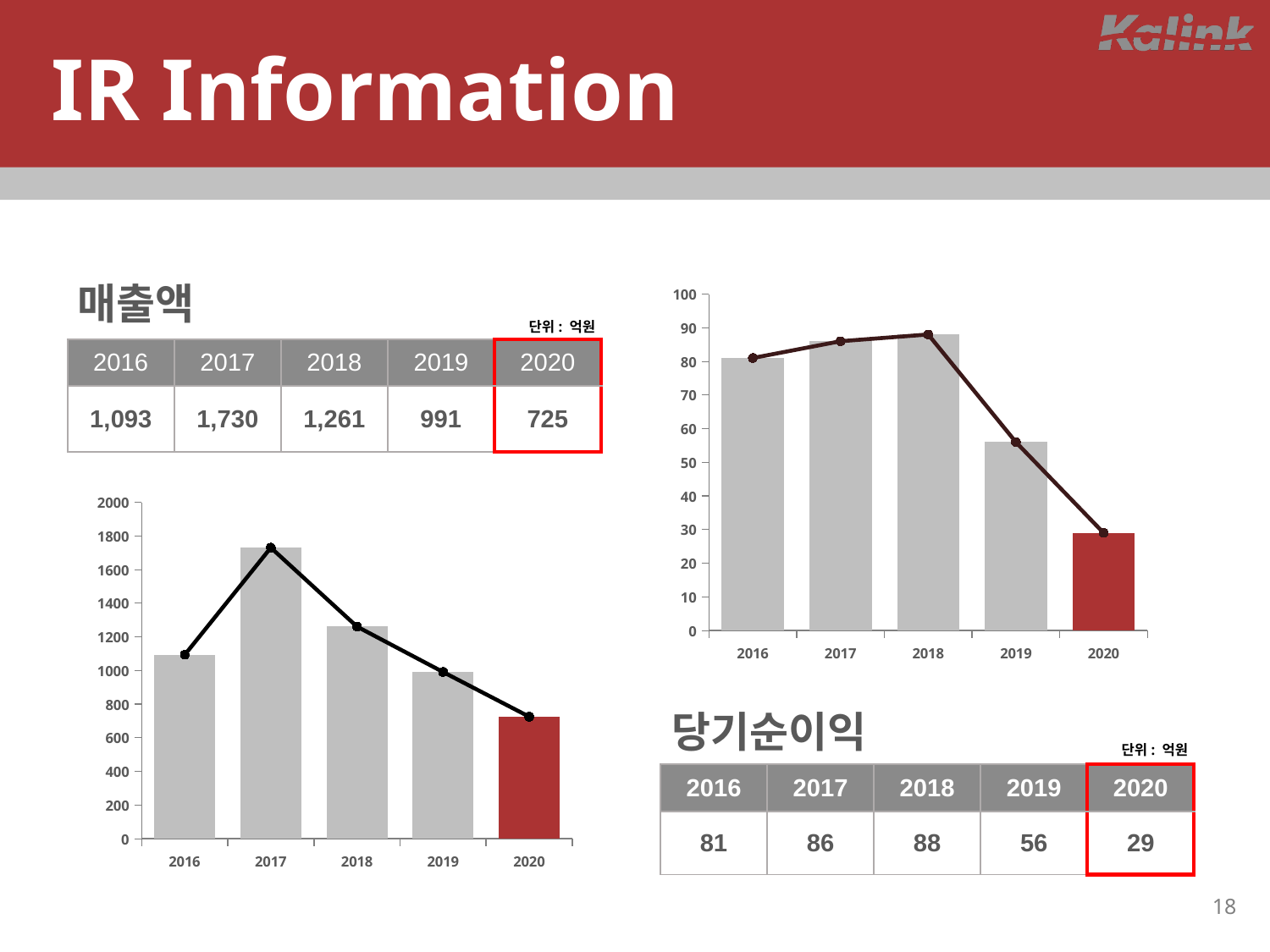
In the 매출액 chart on the left, which year has the lowest value? 2020 In the 매출액 chart on the left, is the value for 2019 greater or less than 1000? less In the 매출액 chart on the left, do the values rise or fall from 2017 to 2020? fall In the 당기순이익 chart on the right, which is larger, the value for 2016 or the value for 2019? 2016 In the 당기순이익 chart on the right, which year has the highest value? 2018 In the 당기순이익 chart on the right, what is the value for 2019? 56 In the 당기순이익 chart on the right, what colour is the bar for 2020? red In the 매출액 chart on the left, what is the difference between the 2017 value and the 2020 value? 1,005 In the 매출액 chart on the left, which year has the highest value? 2017 In the 매출액 chart on the left, what is the value for 2017? 1,730 In the 매출액 chart on the left, how many years are plotted? 5 In the 당기순이익 chart on the right, what is the difference between the 2018 value and the 2020 value? 59